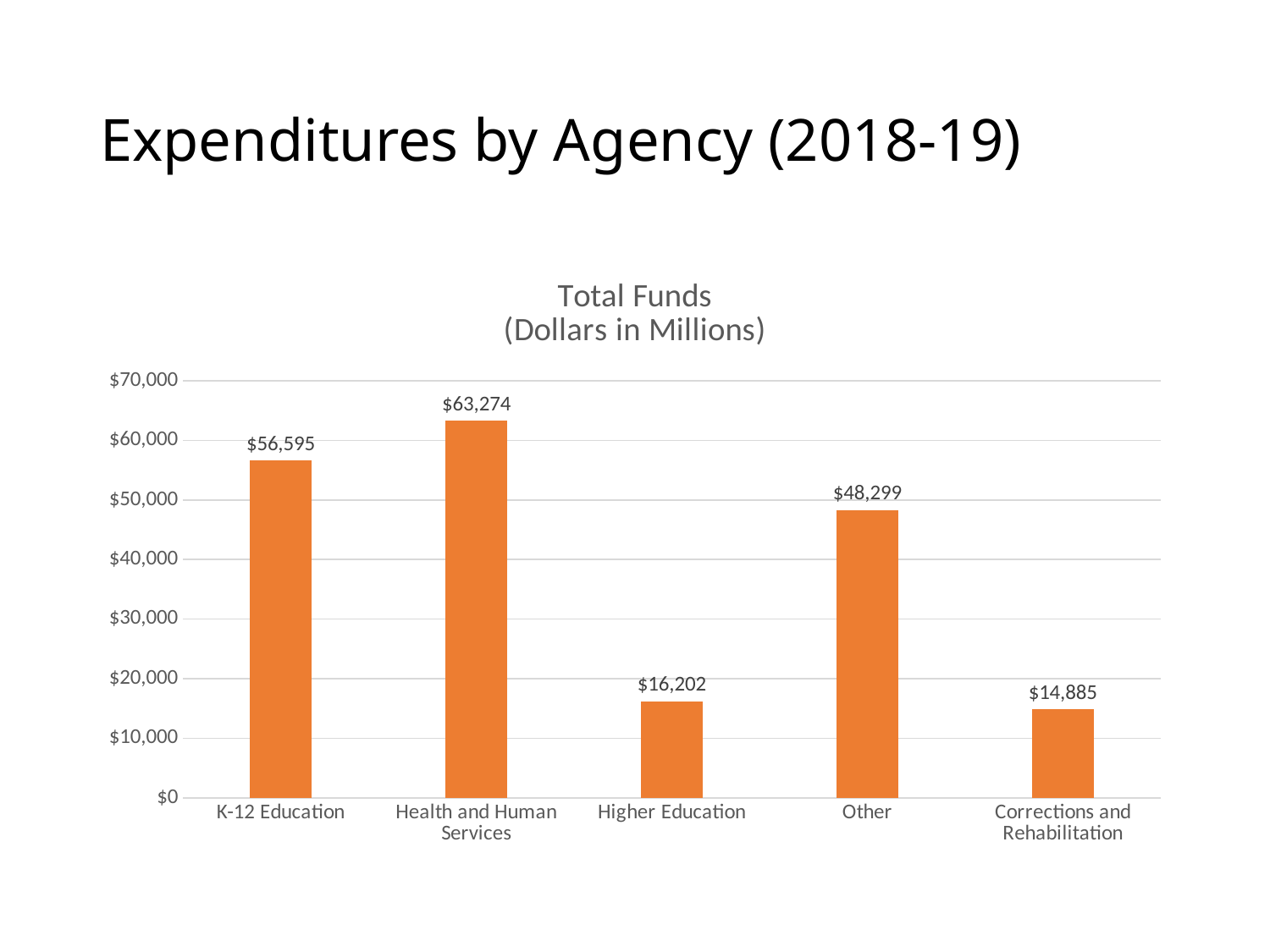
Which category has the highest value? Health and Human Services What is the value for K-12 Education? $56,595 What is the difference between the values for Higher Education and Corrections and Rehabilitation? $1,317 What is the difference between the values for Health and Human Services and K-12 Education? $6,679 Which category has the lowest value? Corrections and Rehabilitation Which is larger, the value for Other or the value for Higher Education? Other What is the title of the chart? Total Funds (Dollars in Millions) What is the value for Corrections and Rehabilitation? $14,885 Is the value for Other greater or less than $50,000? less How many categories are shown on the x axis? 5 What kind of chart is shown on the slide? bar chart What is the value for Health and Human Services? $63,274